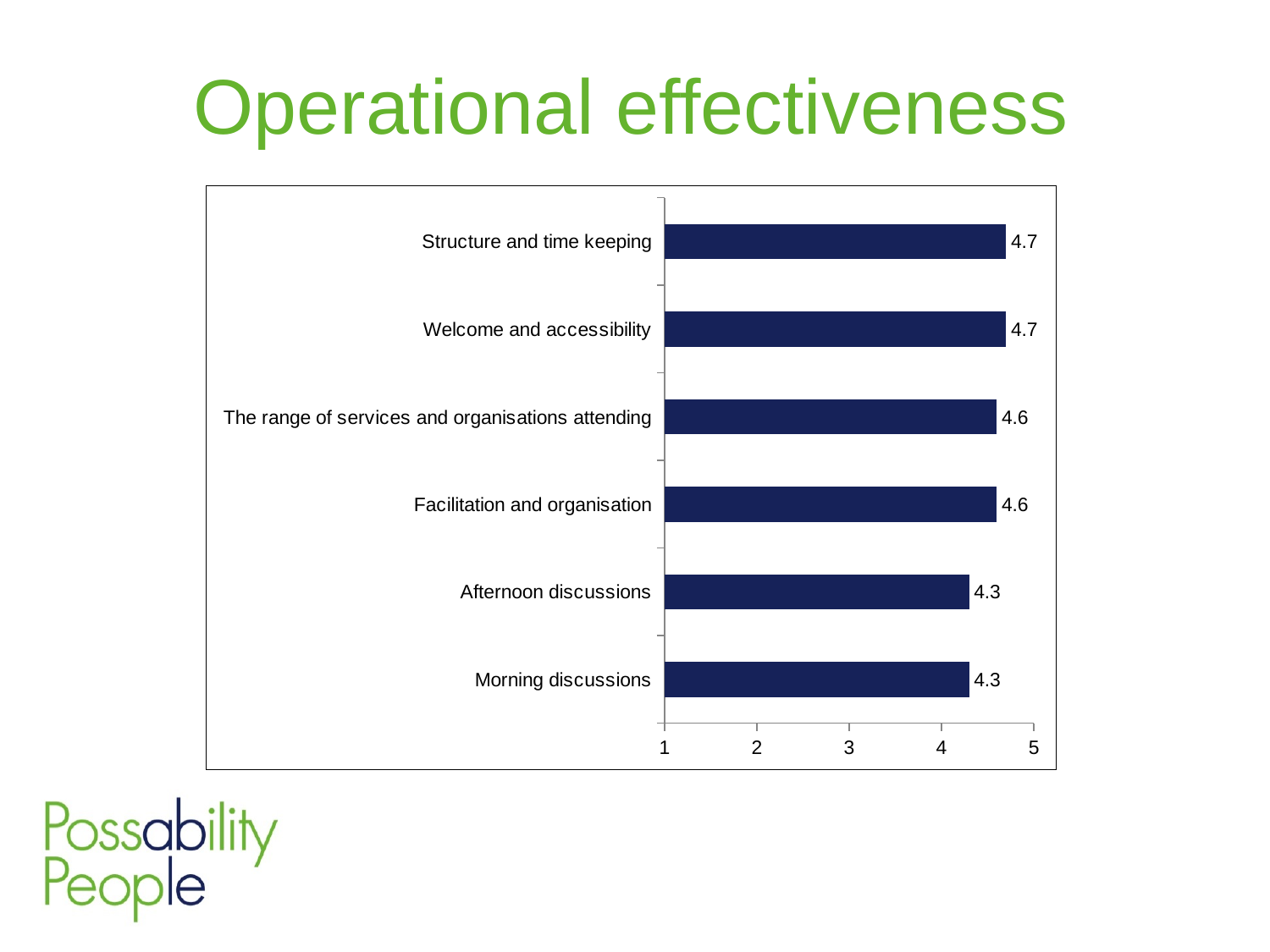
Which is larger, the value for Facilitation and organisation or the value for Afternoon discussions? Facilitation and organisation What is the value for Afternoon discussions? 4.3 Is the value for Morning discussions greater or less than 4? greater How many categories are shown in the chart? 6 What is the difference between the values for Welcome and accessibility and Morning discussions? 0.4 What is the highest value shown on the chart? 4.7 What is the title of the slide? Operational effectiveness What kind of chart is shown on the slide? bar chart What is the value for Morning discussions? 4.3 What is the lowest value shown on the chart? 4.3 What is the value for Structure and time keeping? 4.7 What is the value for The range of services and organisations attending? 4.6